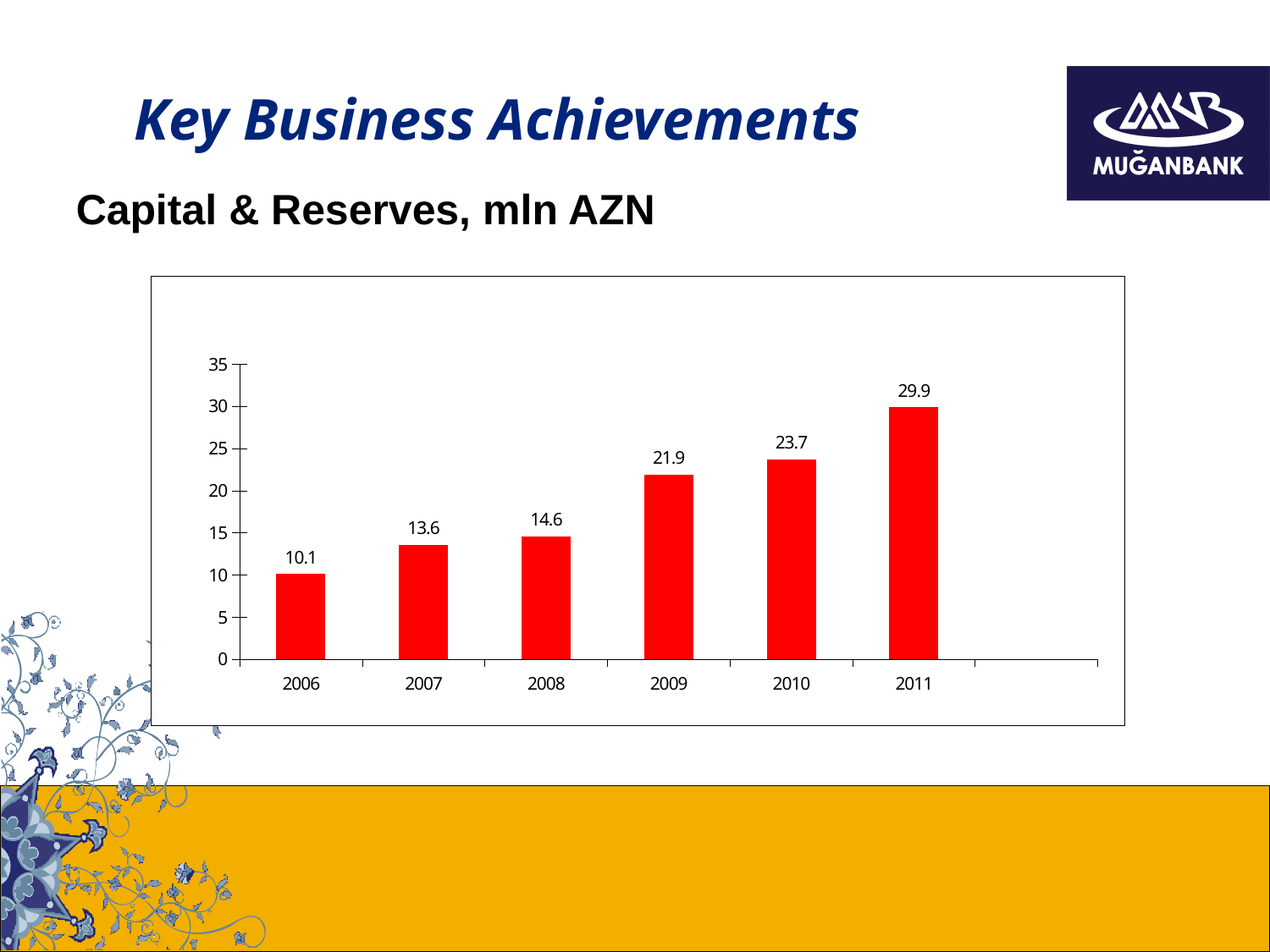
What kind of chart is shown? bar chart What is the difference between the values for 2008 and 2007? 1.0 What is the value for 2006? 10.1 Which year has the lowest value? 2006 Do the values rise or fall from 2006 to 2011? rise Is the value for 2010 greater or less than 20? greater What is the value for 2011? 29.9 What is the value for 2009? 21.9 How many years are shown on the x axis? 6 What is the difference between the values for 2011 and 2006? 19.8 Which year has the highest value? 2011 Which is larger, the value for 2010 or the value for 2009? 2010